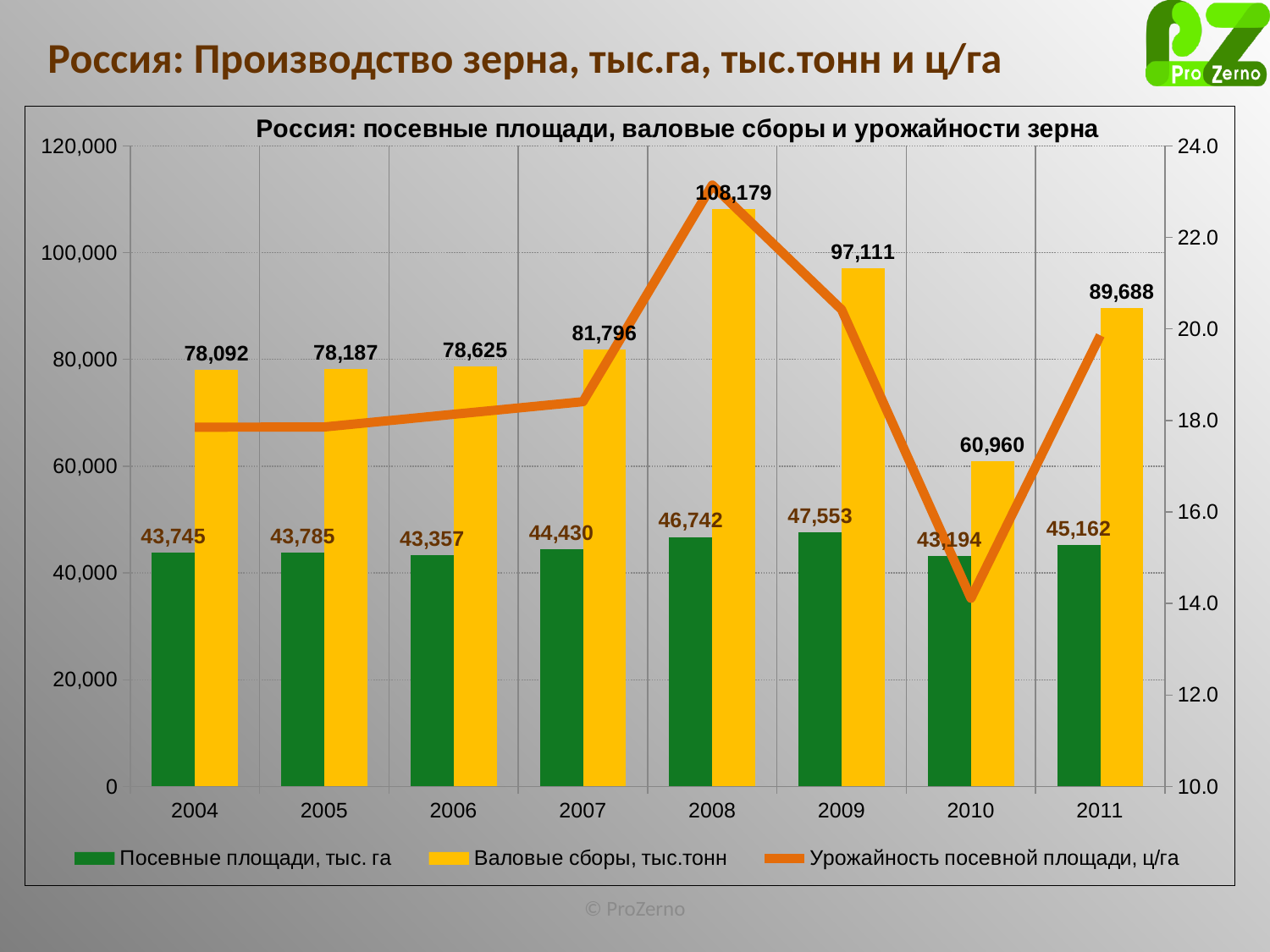
In which year is Посевные площади, тыс. га the highest? 2009 What is the value of Валовые сборы, тыс.тонн for 2008? 108,179 In which year is Валовые сборы, тыс.тонн the highest? 2008 Which year has the larger value of Валовые сборы, тыс.тонн: 2007 or 2011? 2011 Is the value of Урожайность посевной площади, ц/га for 2008 greater or less than 22.0? greater What is the value of Посевные площади, тыс. га for 2009? 47,553 In which year is Валовые сборы, тыс.тонн the lowest? 2010 Is the value of Урожайность посевной площади, ц/га for 2010 greater or less than 16.0? less How many years are shown on the x axis? 8 What is the difference between Валовые сборы, тыс.тонн in 2008 and in 2009? 11,068 How many series does the legend list? 3 Which series is drawn as a line rather than bars? Урожайность посевной площади, ц/га